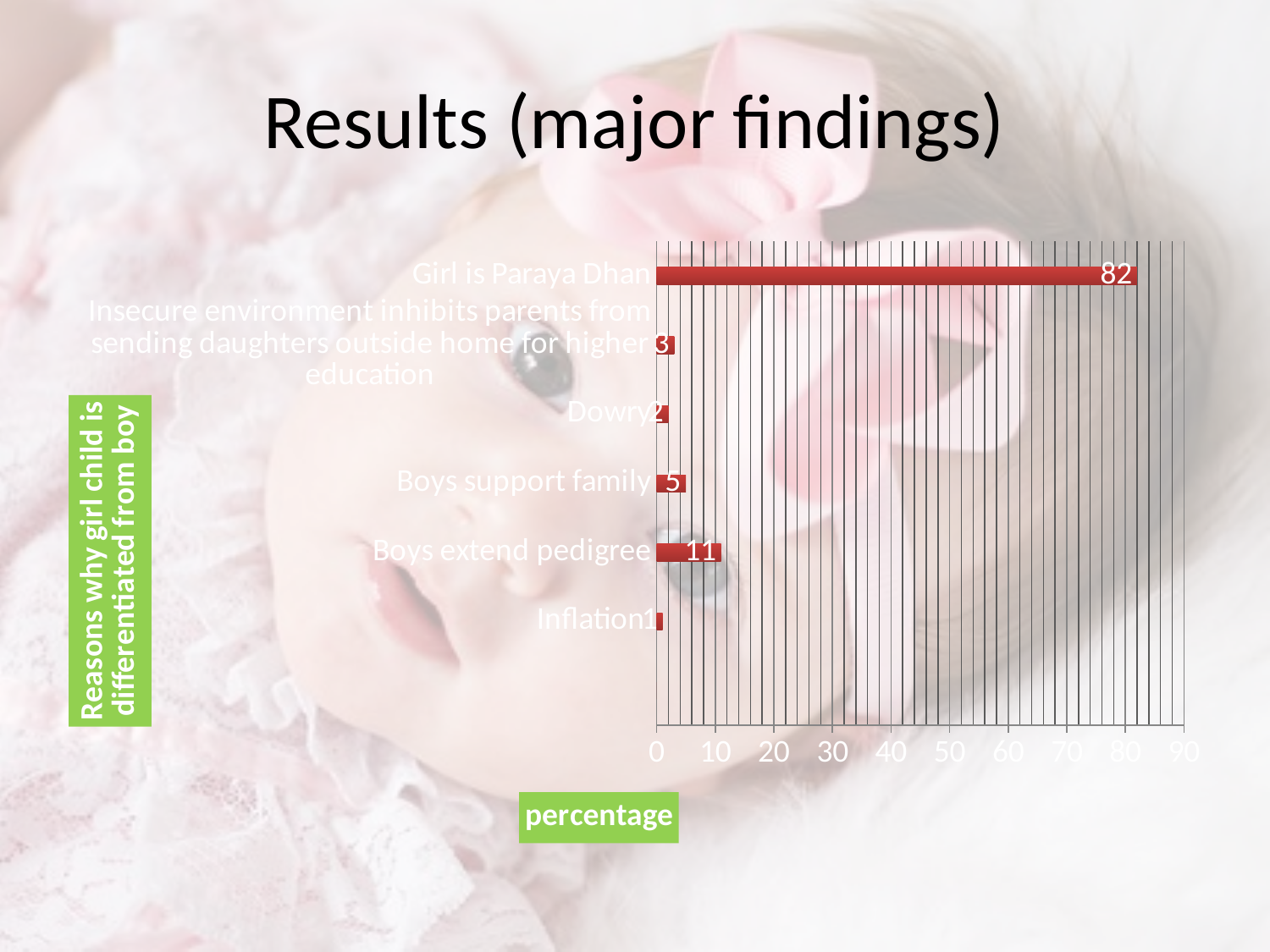
What kind of chart is shown on the slide? Bar chart What is the label of the horizontal axis? percentage Which category has the highest value? Girl is Paraya Dhan What is the value for "Girl is Paraya Dhan"? 82 How many categories are shown in the chart? 6 Which category has the lowest value? Inflation Which is larger, the value for "Boys support family" or the value for "Dowry"? Boys support family What is the value for "Boys extend pedigree"? 11 What is the value for "Dowry"? 2 What is the value for "Boys support family"? 5 What is the difference between the values for "Girl is Paraya Dhan" and "Boys extend pedigree"? 71 What is the value for "Inflation"? 1